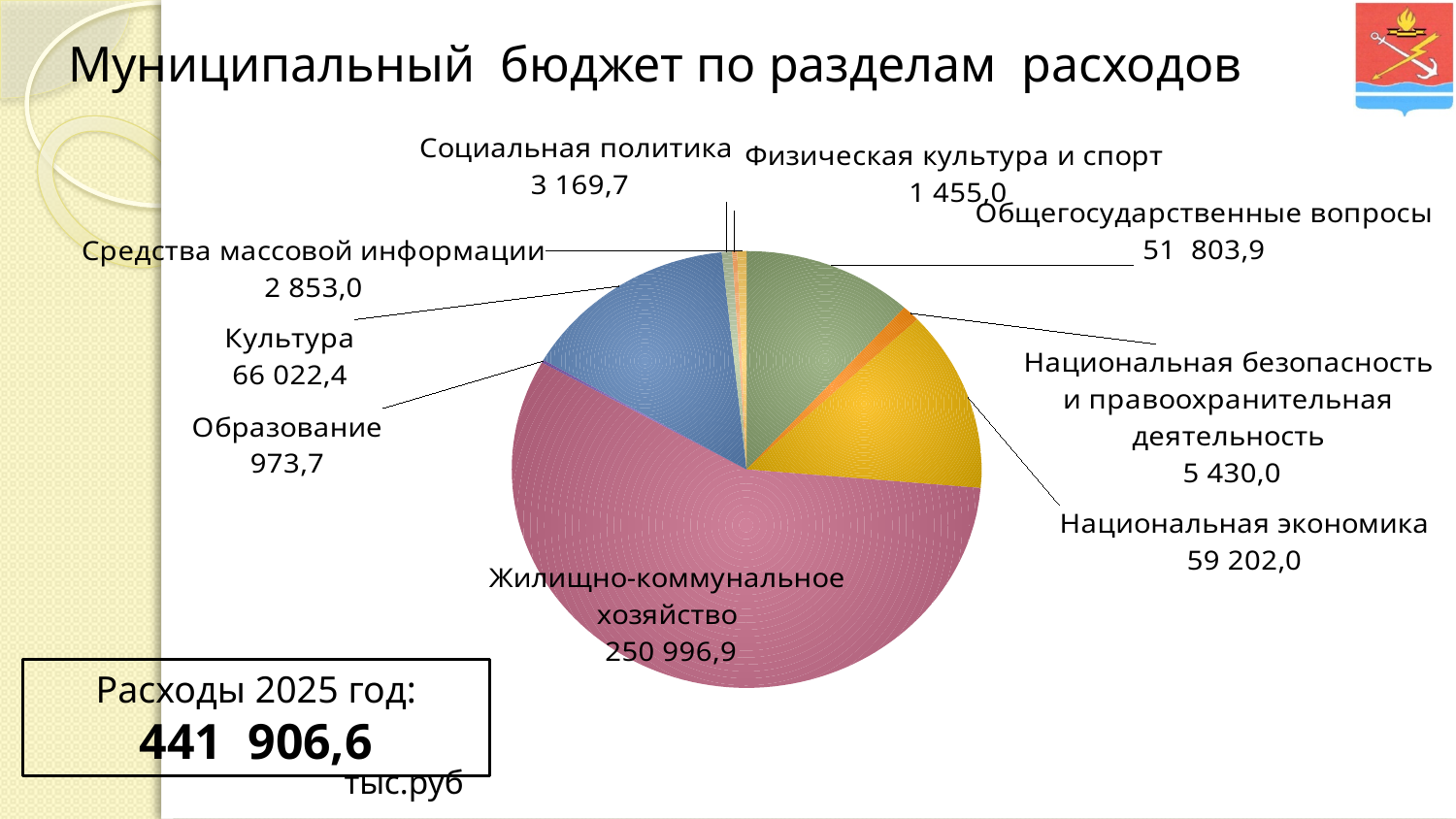
What is the value for Национальная экономика? 59 202,0 What is the value for Физическая культура и спорт? 1 455,0 Which is larger, Культура or Национальная экономика? Культура Which section of expenditure has the largest value? Жилищно-коммунальное хозяйство What is the difference between Культура and Национальная экономика? 6 820,4 How many sections of expenditure are shown in the pie chart? 9 What is the value for Национальная безопасность и правоохранительная деятельность? 5 430,0 What is the title of the slide? Муниципальный бюджет по разделам расходов What kind of chart is shown on the slide? Pie chart What is the value for Жилищно-коммунальное хозяйство? 250 996,9 Which section of expenditure has the smallest value? Образование What is the difference between Социальная политика and Средства массовой информации? 316,7